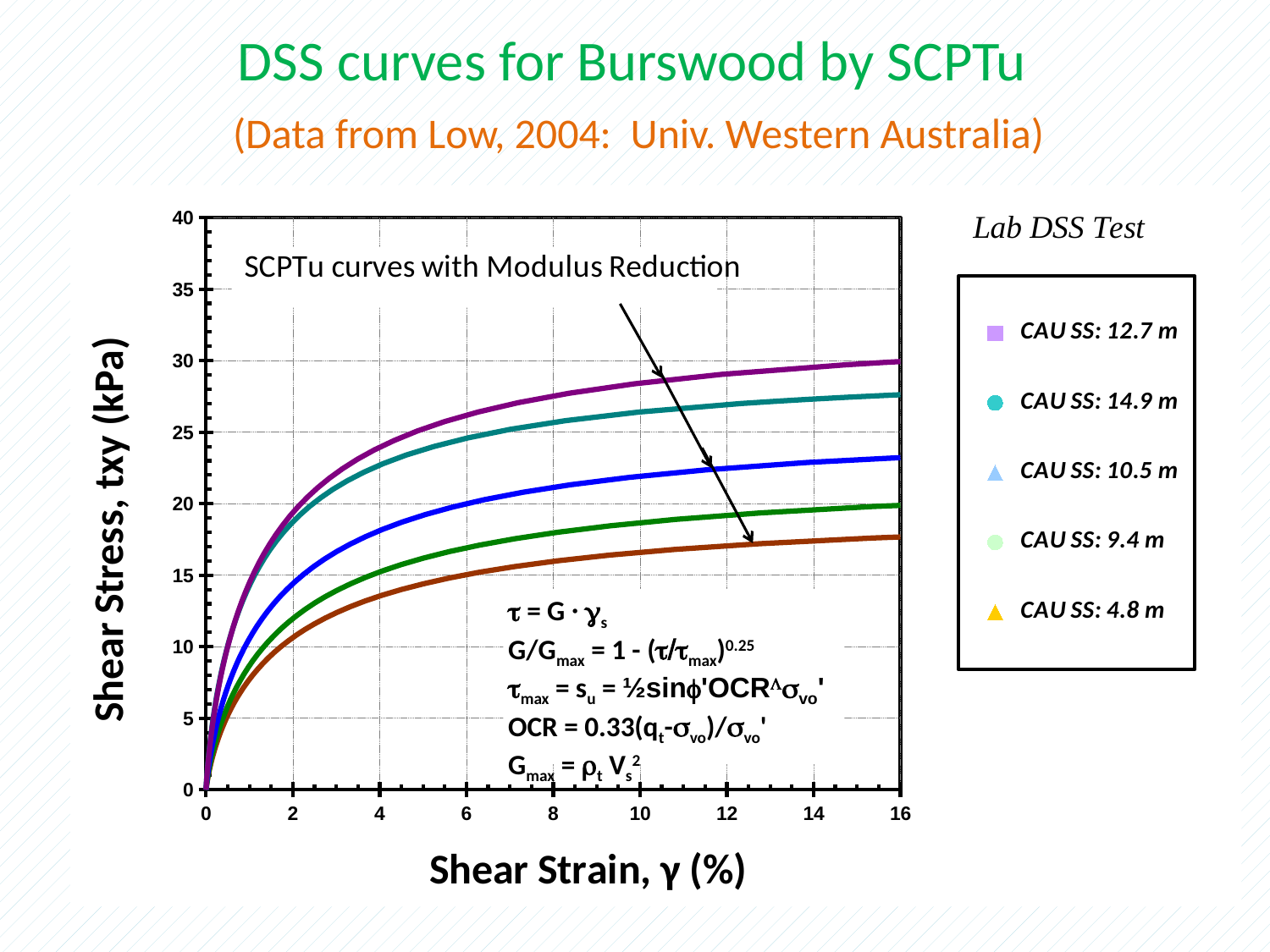
Is the shear stress of the brown curve at a shear strain of 16% greater or less than 20 kPa? less How many curves are plotted on the chart? 5 What is the label of the x axis? Shear Strain, γ (%) What is the label of the y axis? Shear Stress, txy (kPa) Do the curves rise or fall as shear strain increases along the x axis? rise Which curve has the lowest shear stress at a shear strain of 16%? the brown curve How many entries does the legend list? 5 Is the shear stress of the teal curve at a shear strain of 16% greater or less than 25 kPa? greater Is the shear stress of the blue curve at a shear strain of 16% greater or less than 20 kPa? greater What kind of chart is shown on the slide? line chart Which curve reaches the highest shear stress at a shear strain of 16%? the purple curve At a shear strain of 8%, which curve has the larger shear stress, the purple curve or the blue curve? the purple curve